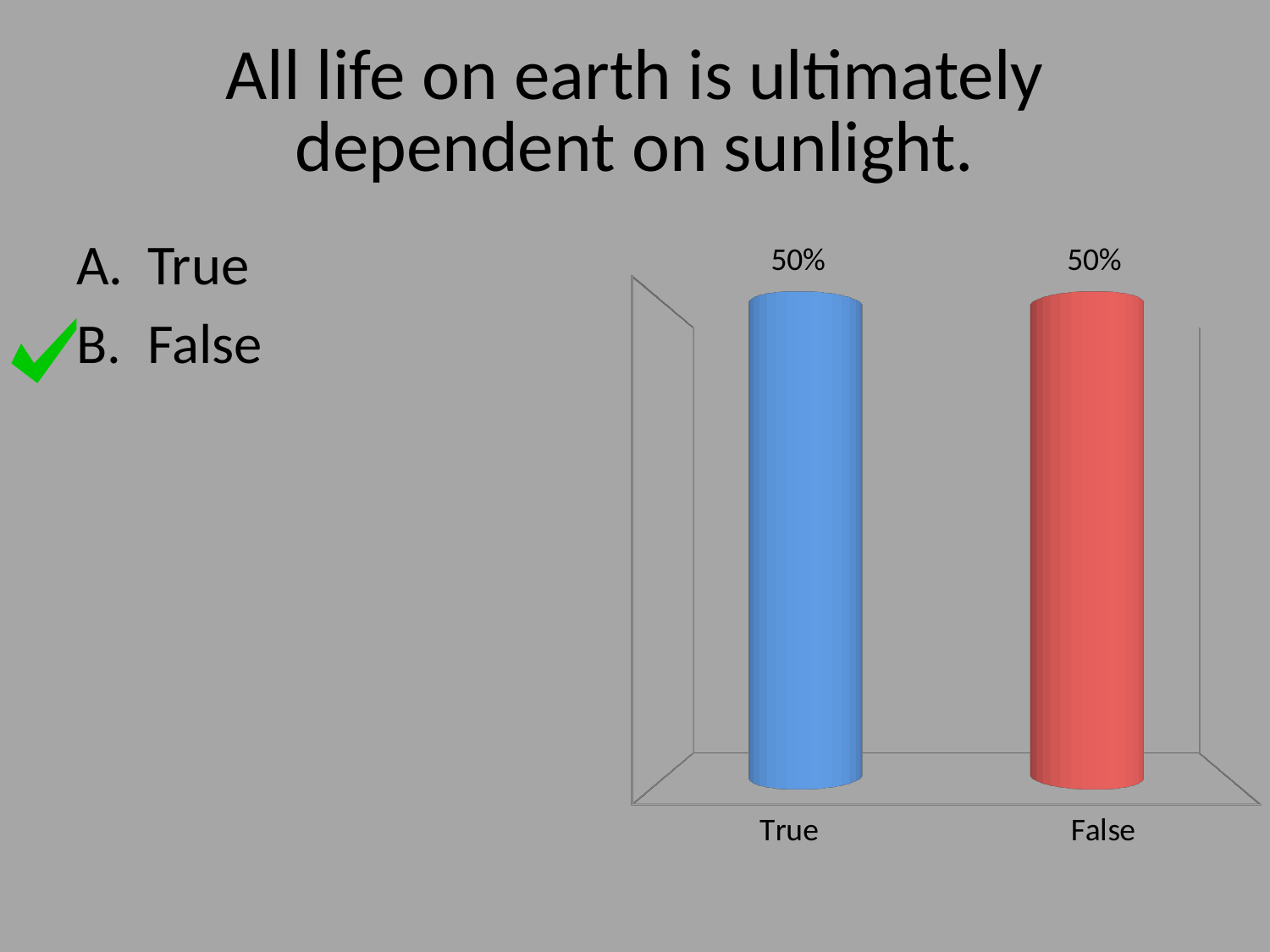
What is the total of the values for True and False? 100% What is the value shown for True? 50% What is the value shown for False? 50% What are the category labels on the x axis? True, False How many categories are shown on the x axis? 2 What is the difference between the values for True and False? 0% What kind of chart is shown on the slide? bar chart What colour is the bar for False? red Are the values for True and False equal, or is one larger? equal